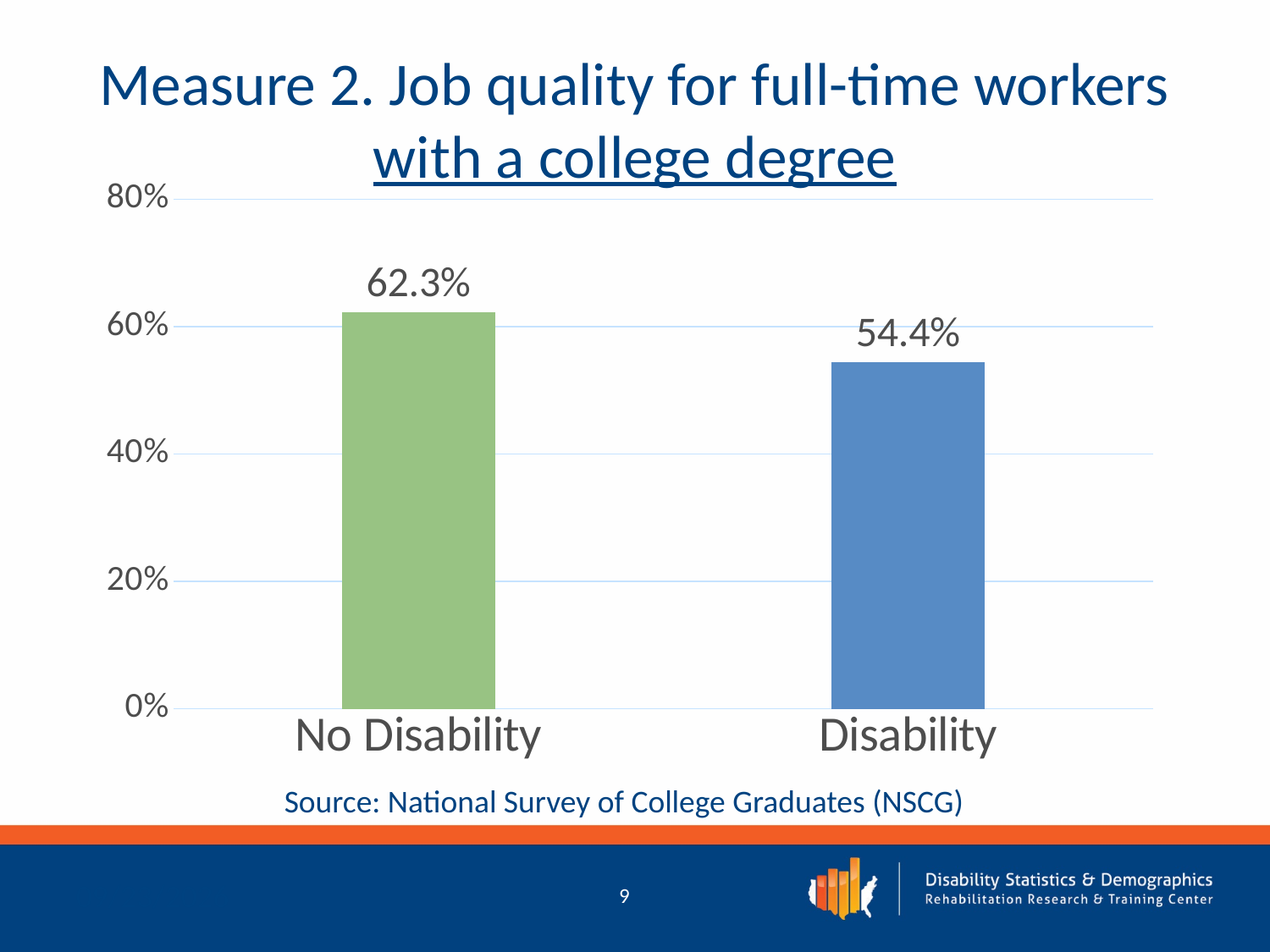
Is the value for No Disability greater or less than 60%? greater What is the source cited below the chart? National Survey of College Graduates (NSCG) What is the value for Disability? 54.4% What is the value for No Disability? 62.3% Is the value for Disability greater or less than 60%? less Which is larger, the value for No Disability or the value for Disability? No Disability How many categories are shown on the x axis? 2 What is the difference between the values for No Disability and Disability? 7.9% What kind of chart is shown on the slide? bar chart Which category has the highest value? No Disability What is the title of the chart? Measure 2. Job quality for full-time workers with a college degree Which category has the lowest value? Disability